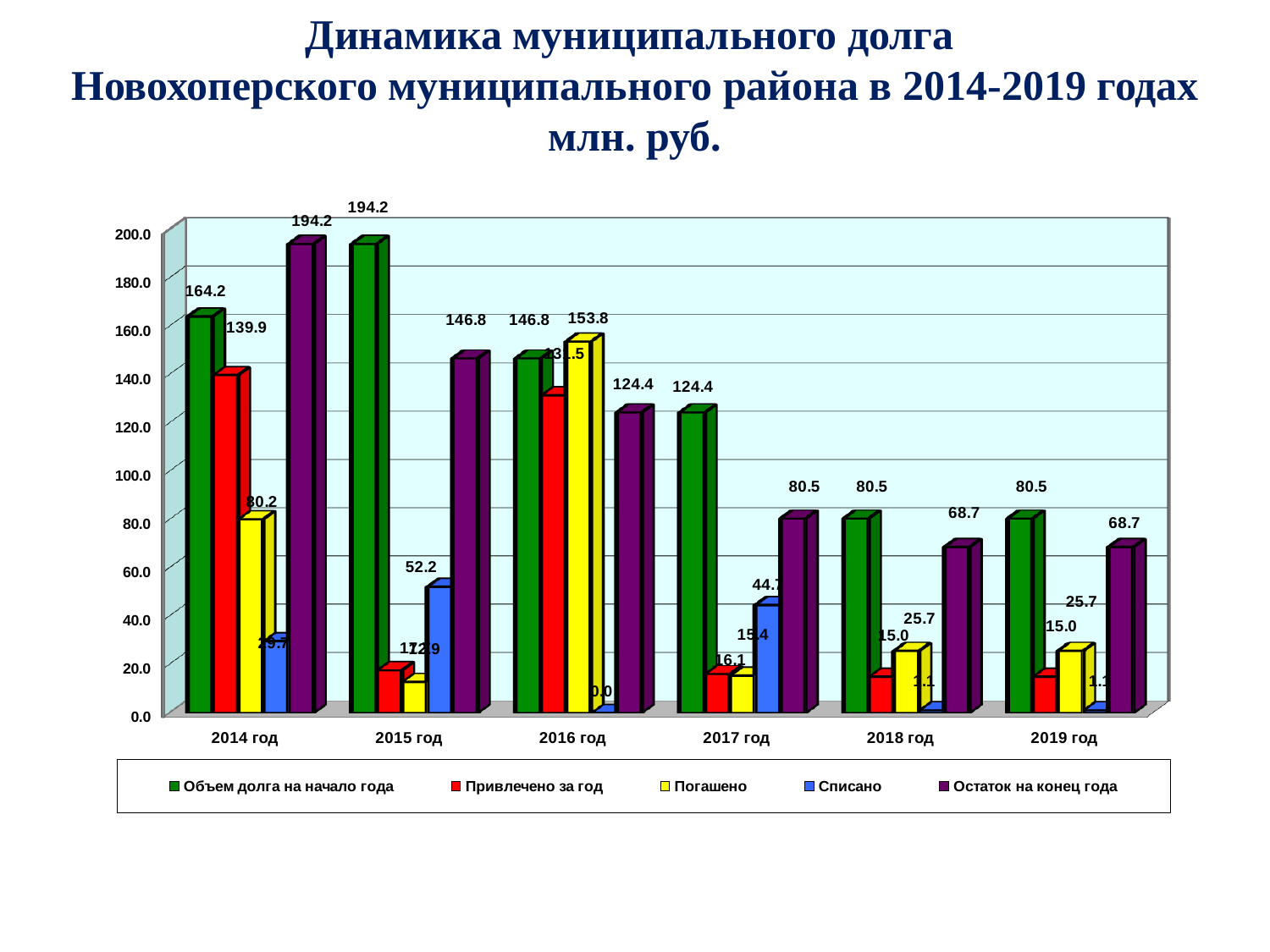
What is the value of "Погашено" for 2016 год? 153.8 Which year has the highest value of "Остаток на конец года"? 2014 год What is the value of "Объем долга на начало года" for 2014 год? 164.2 Which year has the lowest value of "Объем долга на начало года"? 2018 год and 2019 год (80.5) Which is larger for 2016 год: "Объем долга на начало года" or "Погашено"? Погашено Is the value of "Привлечено за год" for 2014 год greater or less than 120.0? greater What is the value of "Остаток на конец года" for 2016 год? 124.4 How many series does the legend list? 5 What is the difference between "Объем долга на начало года" and "Остаток на конец года" for 2018 год? 11.8 What kind of chart is shown on the slide? Bar chart Does the value of "Остаток на конец года" rise or fall from 2014 год to 2019 год? Fall What is the value of "Списано" for 2015 год? 52.2